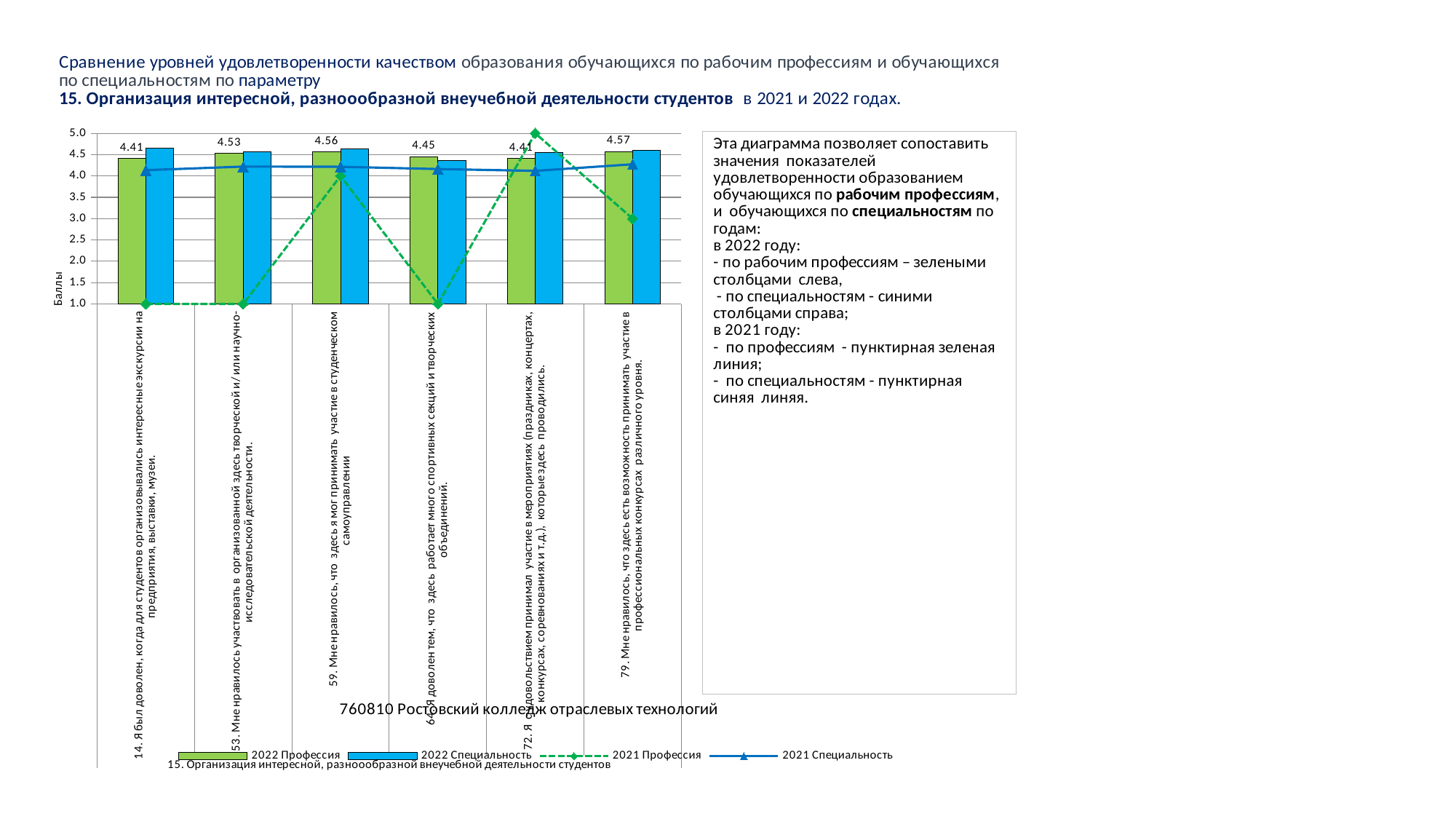
Which statement has the highest 2022 Профессия value? 79. Мне нравилось, что здесь есть возможность принимать участие в профессиональных конкурсах различного уровня What is the 2022 Профессия value for statement 64 (Я доволен тем, что здесь работает много спортивных секций)? 4.45 What is the 2022 Профессия value for statement 14 (Я был доволен, когда для студентов организовывались интересные экскурсии)? 4.41 What is the difference between the 2022 Профессия values for statement 79 and statement 14? 0.16 Is the 2021 Профессия value for statement 14 greater or less than 2.0? less Is the 2021 Специальность value for statement 14 greater or less than 3.0? greater What is the label of the vertical axis of the chart? Баллы How many series does the chart legend list? 4 What is the 2022 Профессия value for statement 59 (Мне нравилось, что здесь я мог принимать участие в студенческом самоуправлении)? 4.56 Is the 2021 Профессия value for statement 72 greater or less than 4.5? greater Which has the larger 2022 Профессия value: statement 53 or statement 14? Statement 53 How many statements (categories) are shown on the x axis of the chart? 6